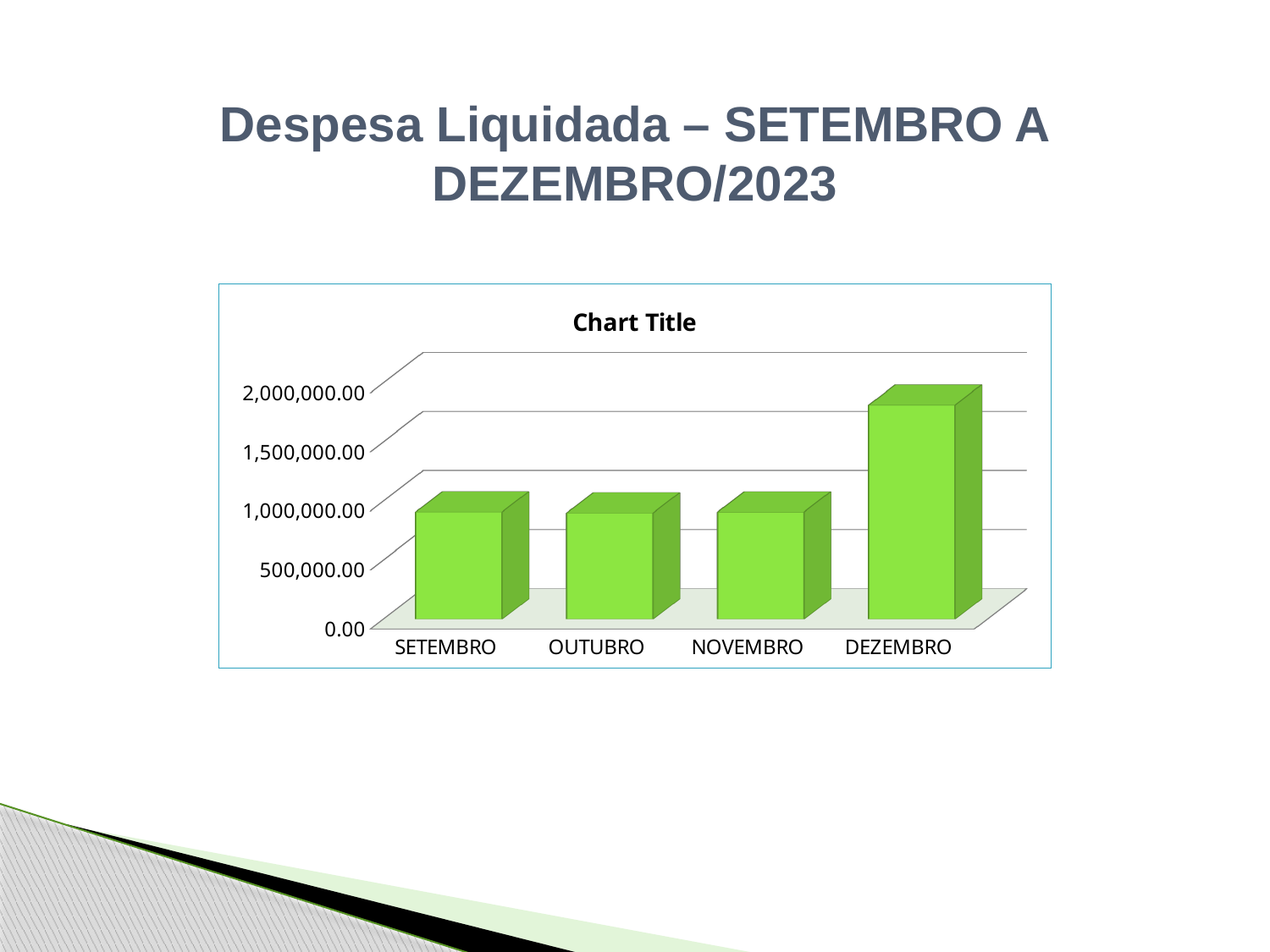
How many categories are shown on the x axis of the chart? 4 Which month has the highest value in the chart? DEZEMBRO What is the first category shown on the x axis of the chart? SETEMBRO Which is larger, the value for DEZEMBRO or the value for SETEMBRO? DEZEMBRO Is the value for NOVEMBRO greater or less than 1,500,000.00? less Is the value for OUTUBRO greater or less than 500,000.00? greater Which is larger, the value for NOVEMBRO or the value for DEZEMBRO? DEZEMBRO Is the value for DEZEMBRO greater or less than 1,500,000.00? greater What kind of chart is shown on the slide? bar chart What title is printed above the chart's plot area? Chart Title